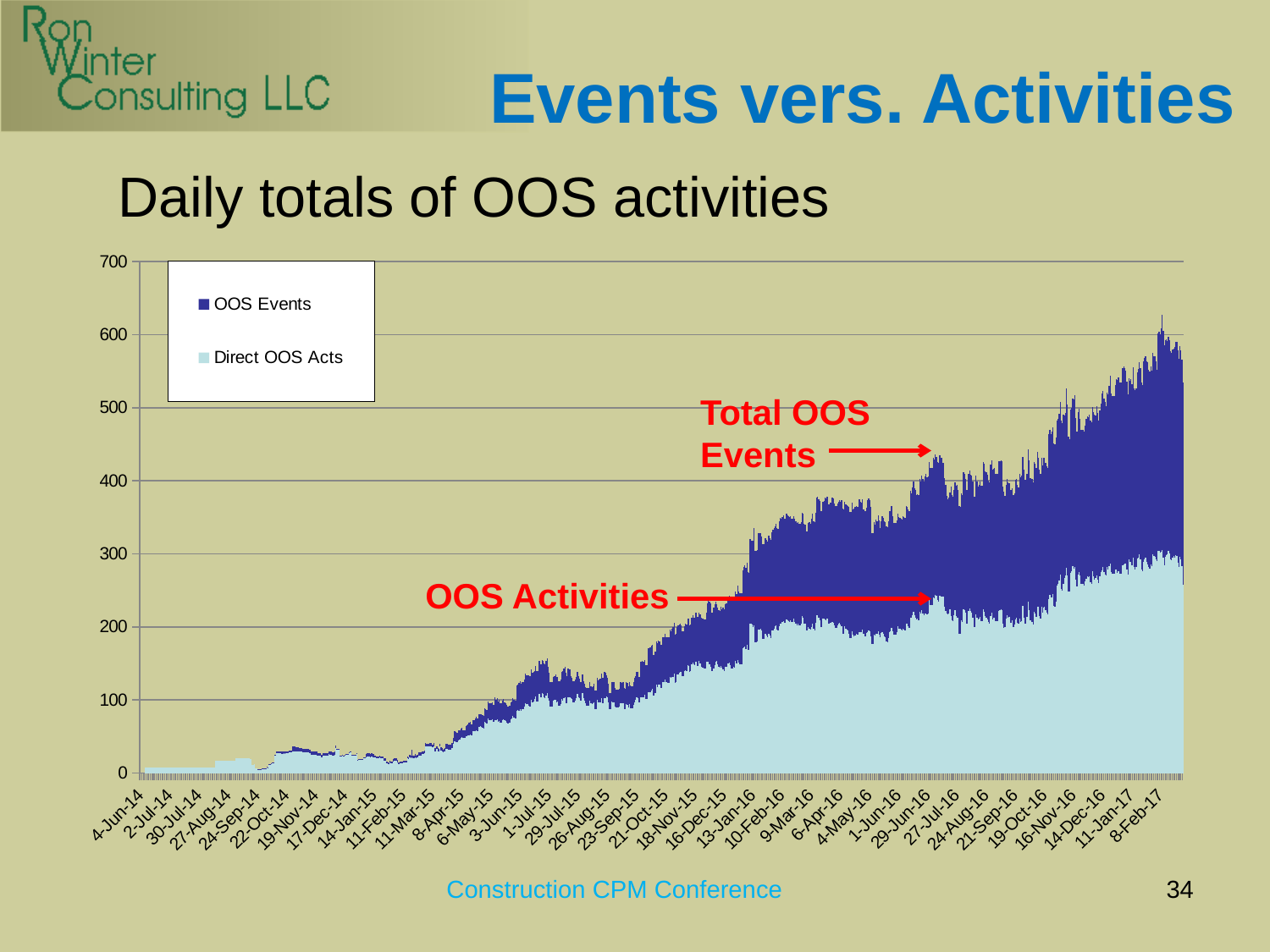
Is the Direct OOS Acts value near 8-Feb-17 greater or less than 200? greater Is the total OOS events value near 8-Feb-17 greater or less than 500? greater What is the title shown above the chart? Daily totals of OOS activities What kind of chart is shown on the slide? Stacked area chart What are the two series named in the legend? OOS Events and Direct OOS Acts Is the total OOS events value near 10-Feb-16 greater or less than 300? greater How many series does the legend list? 2 What is the highest value shown on the vertical axis? 700 Do the total OOS events values generally rise or fall from 4-Jun-14 to 8-Feb-17? Rise